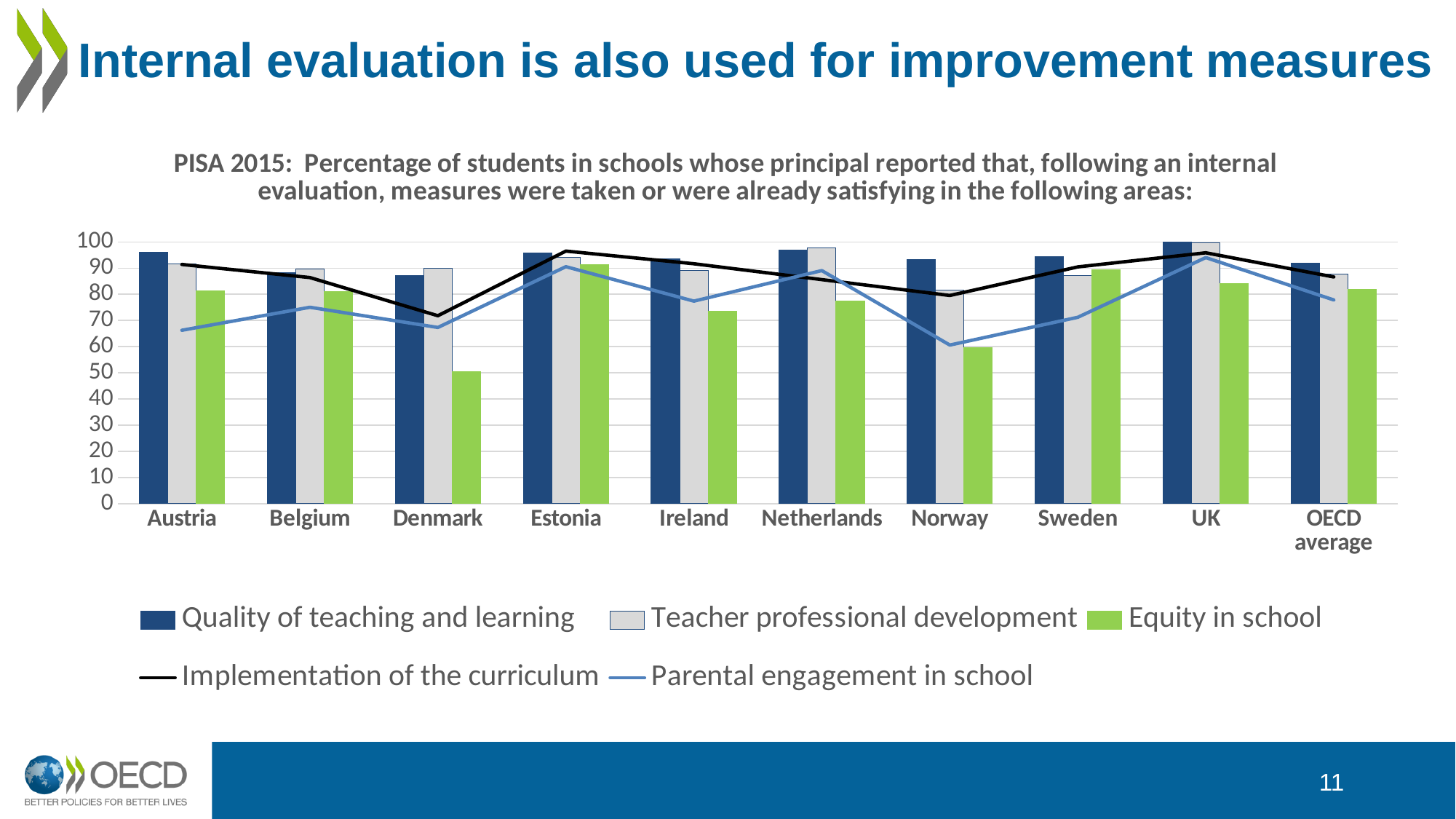
Which colour represents Equity in school in the legend? Green What kind of chart is this? Bar chart with line series Which country has the lowest value for Equity in school? Denmark Is the value for Equity in school in Denmark greater or less than 60? less Which country has the lowest value for Implementation of the curriculum? Denmark Is the value for Implementation of the curriculum in Denmark greater or less than 80? less How many countries/categories are shown on the x axis? 10 How many series does the legend list? 5 Is the value for Parental engagement in school in Austria greater or less than 60? greater In Denmark, which is larger: Quality of teaching and learning or Equity in school? Quality of teaching and learning Which is larger for Teacher professional development: Netherlands or Norway? Netherlands Which country has the highest value for Quality of teaching and learning? UK